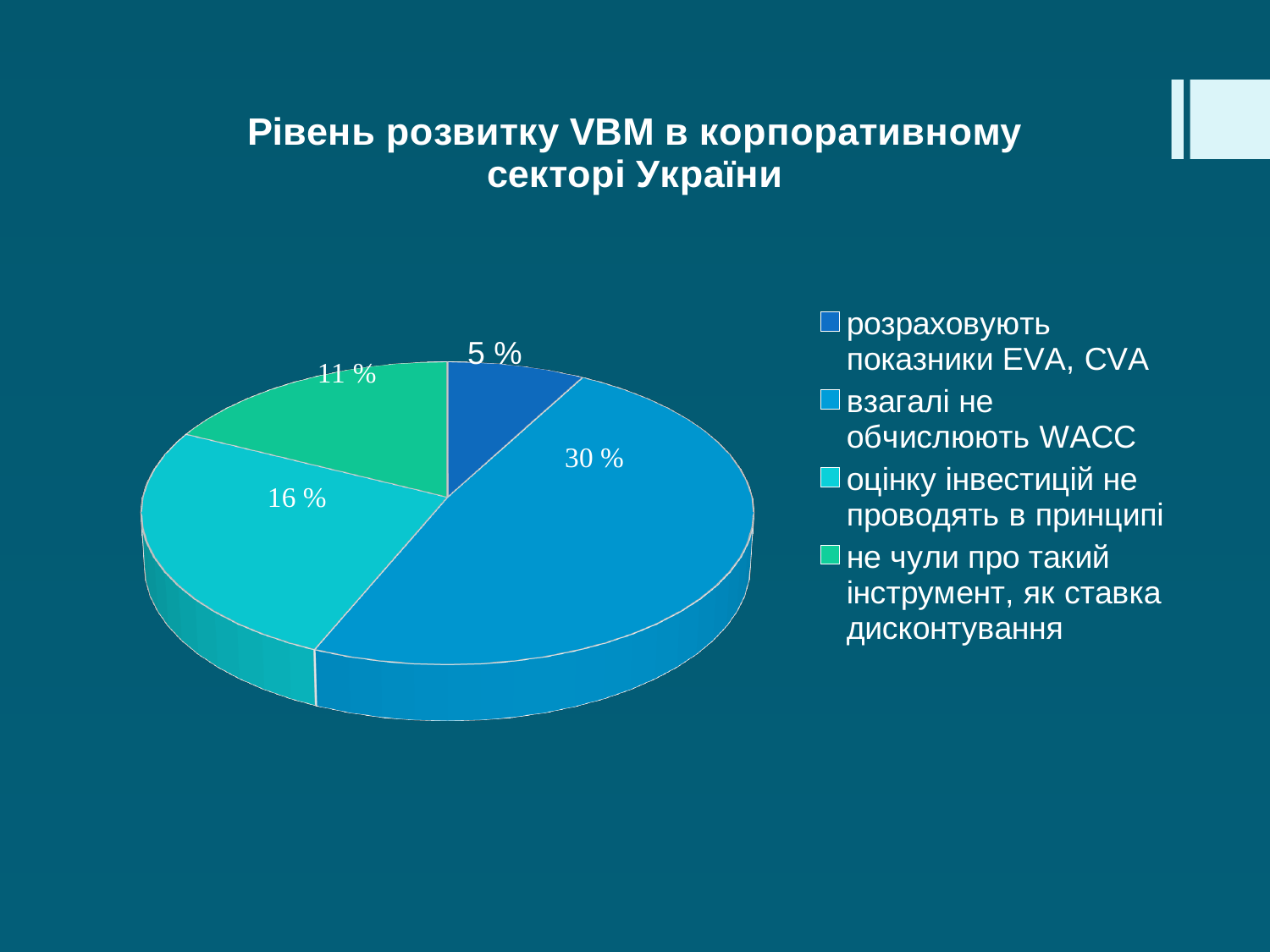
What value is shown for the slice "оцінку інвестицій не проводять в принципі"? 16 % What type of chart is shown on the slide? Pie chart What value is shown for the slice "не чули про такий інструмент, як ставка дисконтування"? 11 % What value is shown for the slice "взагалі не обчислюють WACC"? 30 % How many slices does the pie chart have? 4 How many entries does the legend list? 4 Which is larger: the value for "оцінку інвестицій не проводять в принципі" or the value for "не чули про такий інструмент, як ставка дисконтування"? оцінку інвестицій не проводять в принципі What is the difference between the values for "взагалі не обчислюють WACC" and "оцінку інвестицій не проводять в принципі"? 14 % What is the title of the chart on the slide? Рівень розвитку VBM в корпоративному секторі України What value is shown for the slice "розраховують показники EVA, CVA"? 5 % Which category has the largest slice in the pie chart? взагалі не обчислюють WACC Which category has the smallest slice in the pie chart? розраховують показники EVA, CVA